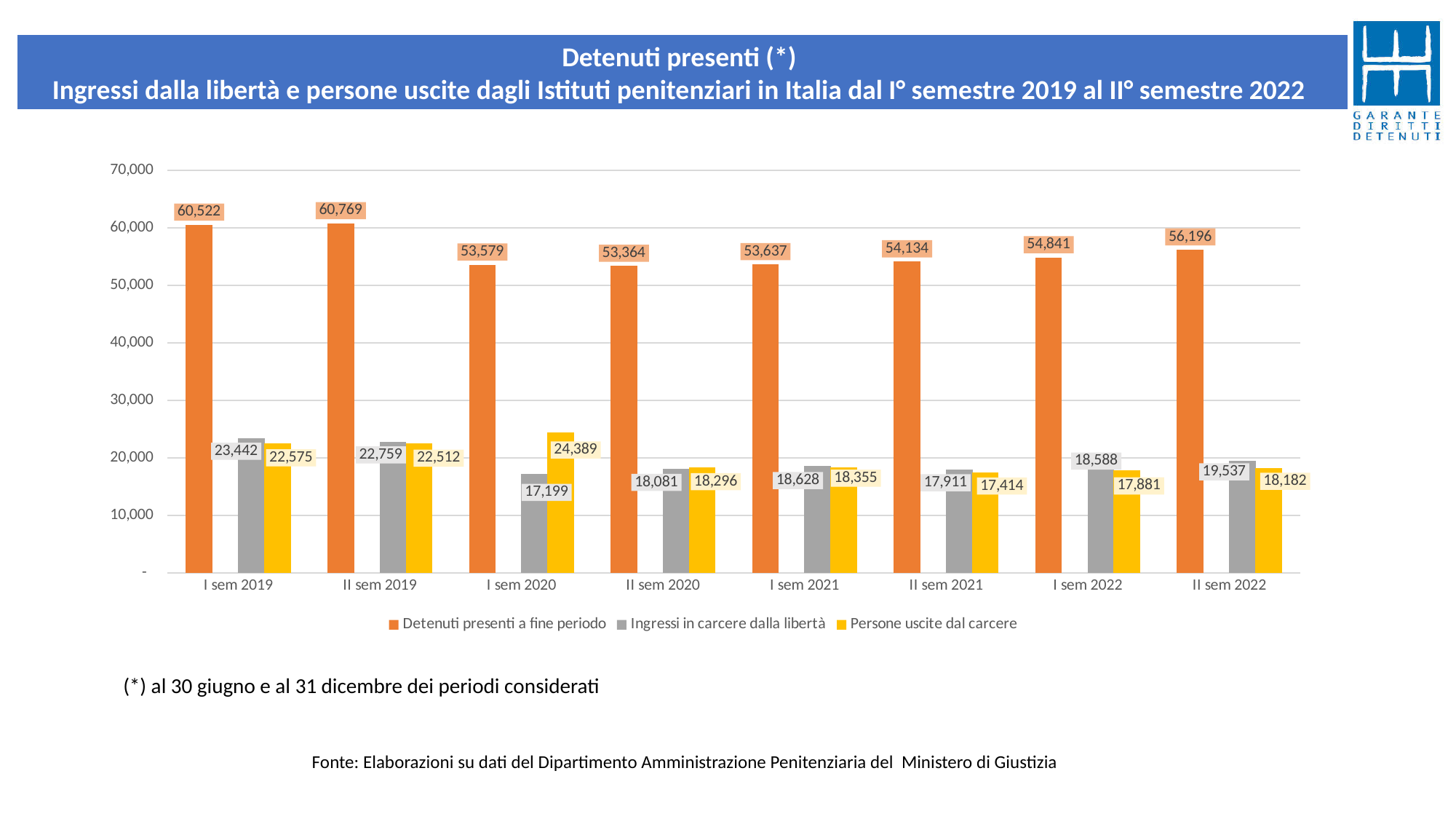
Is the value of 'Detenuti presenti a fine periodo' for I sem 2021 greater or less than 60,000? less In which period is 'Detenuti presenti a fine periodo' highest? II sem 2019 What is the value of 'Persone uscite dal carcere' for I sem 2020? 24,389 What is the difference between 'Persone uscite dal carcere' and 'Ingressi in carcere dalla libertà' in I sem 2020? 7,190 In which period is 'Ingressi in carcere dalla libertà' lowest? I sem 2020 How many periods are shown on the x axis? 8 Which is larger in II sem 2021: 'Ingressi in carcere dalla libertà' or 'Persone uscite dal carcere'? Ingressi in carcere dalla libertà What is the value of 'Detenuti presenti a fine periodo' for I sem 2019? 60,522 How many series does the legend list? 3 What is the value of 'Ingressi in carcere dalla libertà' for II sem 2022? 19,537 What kind of chart is shown on the slide? bar chart What is the difference in 'Detenuti presenti a fine periodo' between II sem 2022 and I sem 2022? 1,355